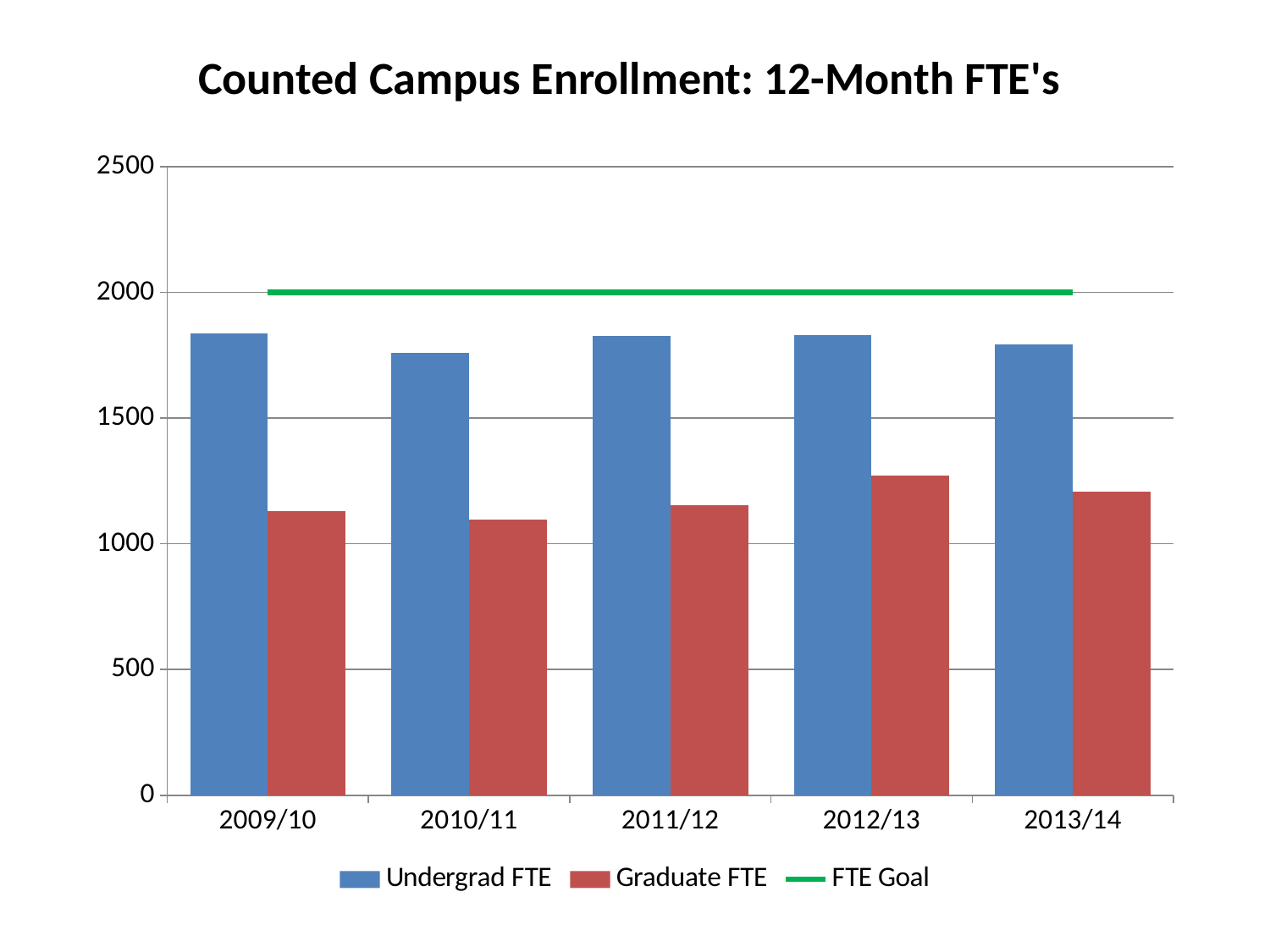
Which is larger, Graduate FTE in 2012/13 or Graduate FTE in 2009/10? 2012/13 Is the Undergrad FTE value for 2013/14 greater or less than 2000? less What type of chart is shown on the slide? Combination bar and line chart In which year is Graduate FTE highest? 2012/13 Which is larger in 2011/12, Undergrad FTE or Graduate FTE? Undergrad FTE What is the title of the chart? Counted Campus Enrollment: 12-Month FTE's Is the Graduate FTE value for 2010/11 greater or less than 1000? greater What value does the FTE Goal line sit at? 2000 How many series does the legend list? 3 Is the Graduate FTE value for 2012/13 greater or less than 1500? less How many academic years are shown on the x axis? 5